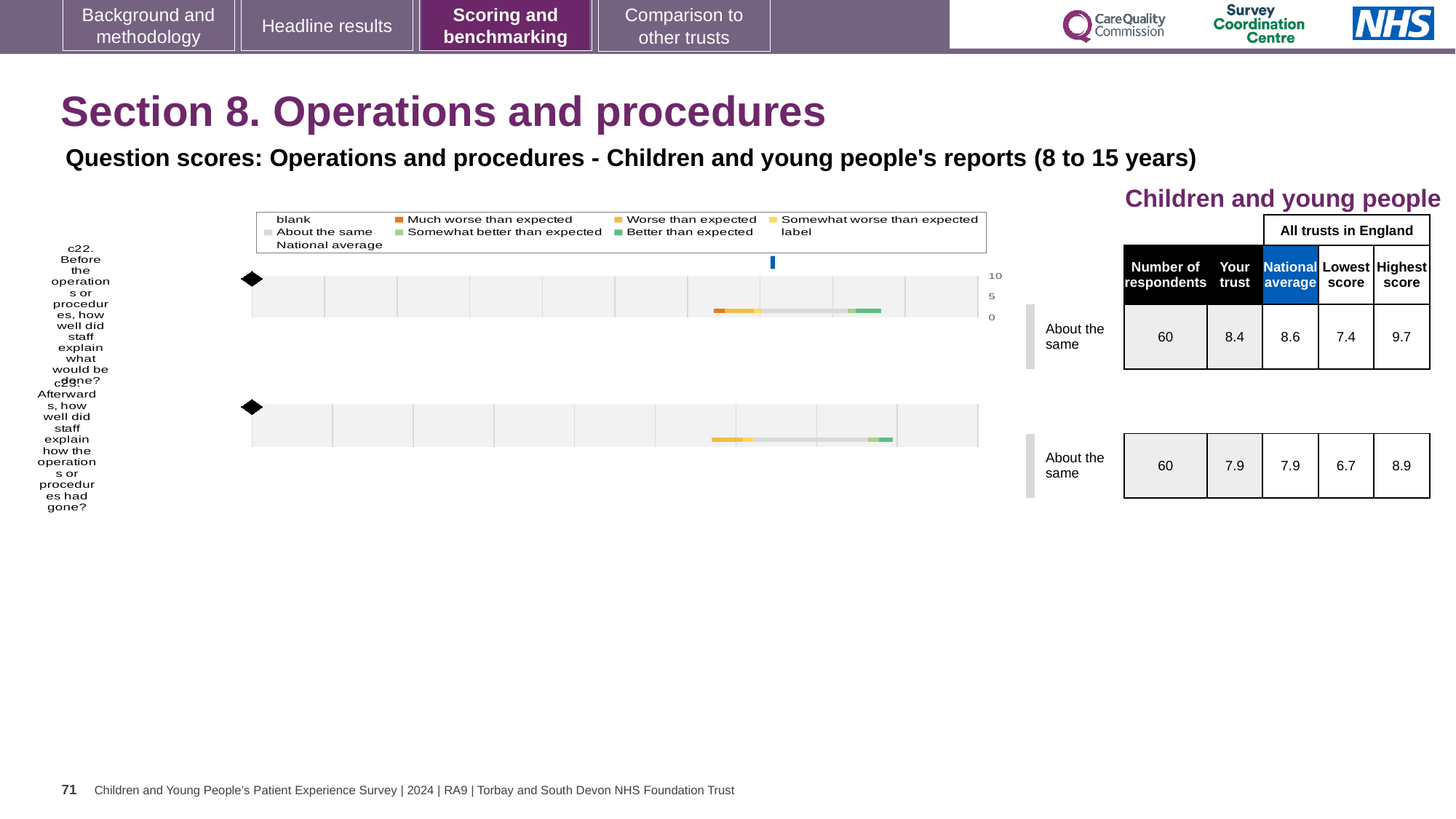
For the c22 chart, what is the 'Your trust' score shown in the table? 8.4 For the c22 chart, what is the national average score shown in the table? 8.6 What benchmark category is shown next to the c22 chart? About the same For the c22 chart, what is the difference between the highest score and the lowest score in the table? 2.3 What benchmark category is shown next to the c23 chart? About the same How many benchmark charts are shown on the slide? 2 What kind of chart is used for question c22 on the slide? bar chart For the c23 chart, how many respondents are shown in the table? 60 For the c23 chart, what is the 'Your trust' score shown in the table? 7.9 What is the highest tick value shown on the axis of the top (c22) chart? 10 For the c22 chart, which is larger: the trust's score or the national average? national average In the legend, what colour represents 'Much worse than expected'? orange